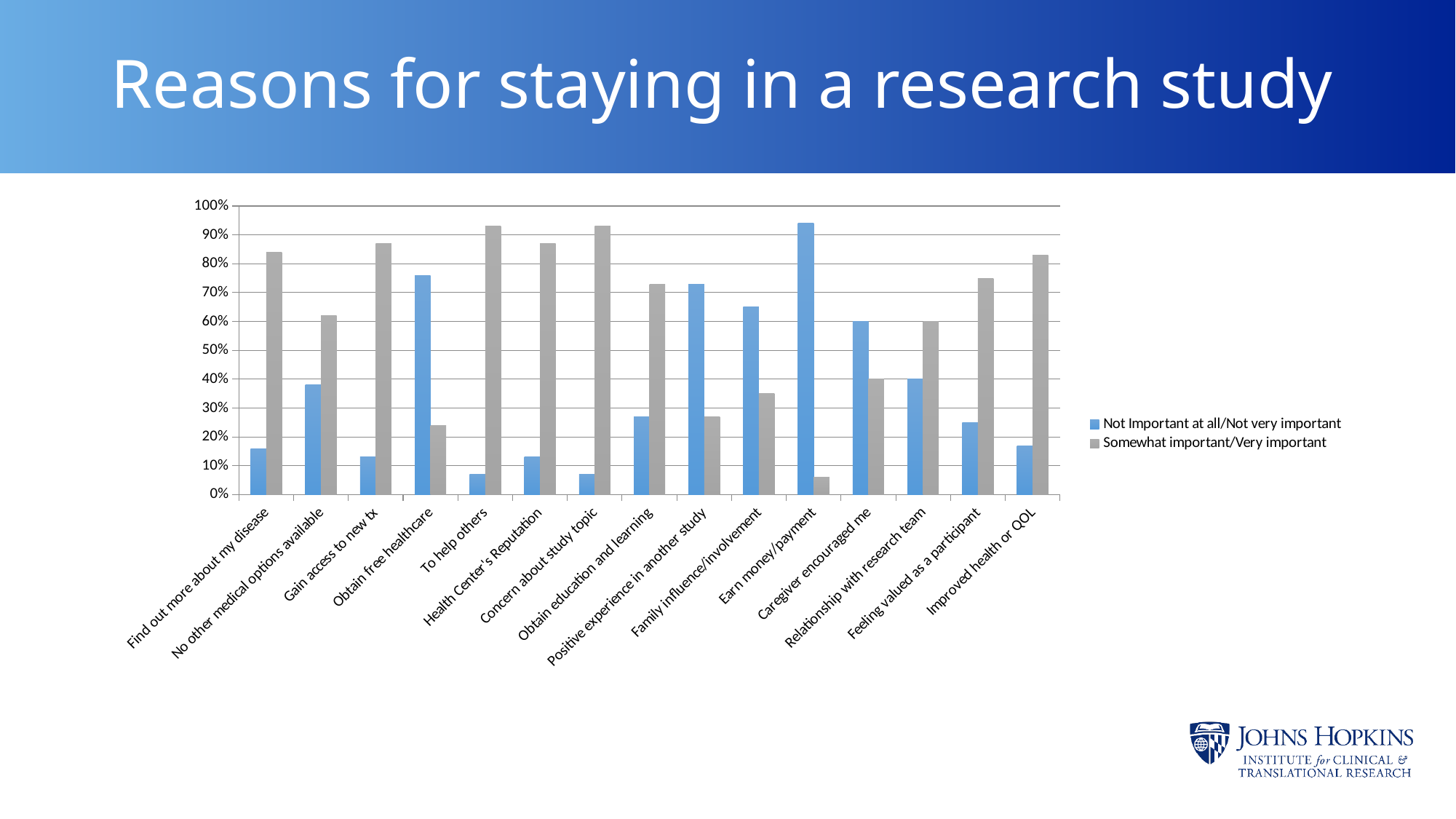
Is the 'Not Important at all/Not very important' value for 'Family influence/involvement' greater or less than 60%? greater How many reasons (categories) are shown on the x axis? 15 Is the 'Somewhat important/Very important' value for 'Feeling valued as a participant' greater or less than 70%? greater What kind of chart is shown on the slide? bar chart Which reason has the lowest 'Somewhat important/Very important' value? Earn money/payment Is the 'Not Important at all/Not very important' value for 'Gain access to new tx' greater or less than 20%? less For 'Obtain free healthcare', which series has the larger value? Not Important at all/Not very important For 'Improved health or QOL', which series has the larger value? Somewhat important/Very important How many series does the legend list? 2 Which reason has the highest 'Not Important at all/Not very important' value? Earn money/payment What colour are the bars for the 'Somewhat important/Very important' series? gray